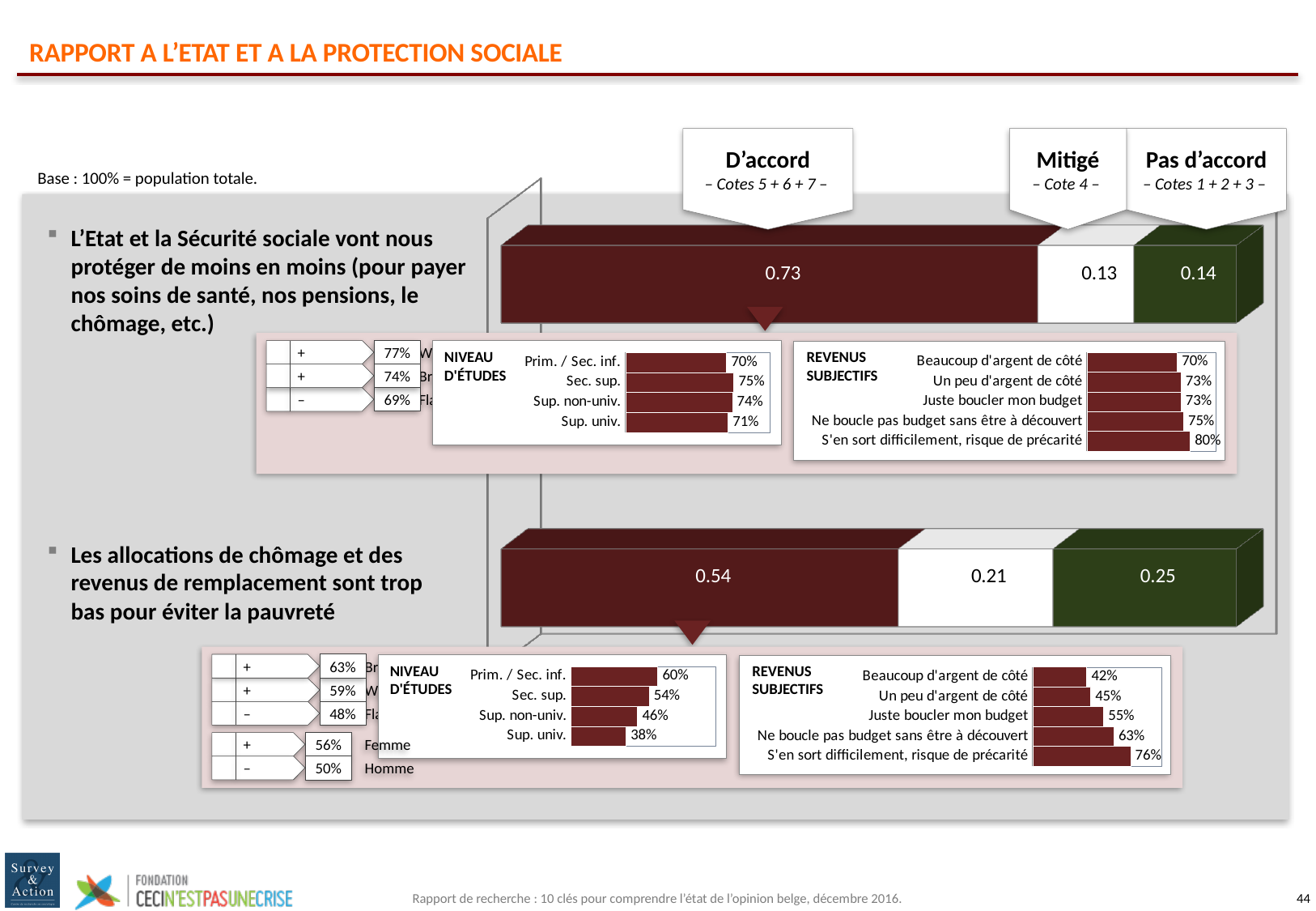
In the top 'NIVEAU D'ÉTUDES' bar chart (under the statement about 'L'Etat et la Sécurité sociale'), what is the value for 'Sup. non-univ.'? 74% In the bottom 'NIVEAU D'ÉTUDES' bar chart (under the statement about 'allocations de chômage'), do the values rise or fall from 'Prim. / Sec. inf.' to 'Sup. univ.'? fall In the top 'REVENUS SUBJECTIFS' bar chart (under the statement about 'L'Etat et la Sécurité sociale'), what is the value for 'S'en sort difficilement, risque de précarité'? 80% In the bottom 'REVENUS SUBJECTIFS' bar chart (under the statement about 'allocations de chômage'), what is the difference between 'S'en sort difficilement, risque de précarité' and 'Beaucoup d'argent de côté'? 34% In the bottom 'NIVEAU D'ÉTUDES' bar chart (under the statement about 'allocations de chômage'), which category has the lowest value? Sup. univ. In the top stacked bar for the statement 'L'Etat et la Sécurité sociale vont nous protéger de moins en moins', what is the value for 'D'accord'? 0.73 In the bottom stacked bar for the statement 'Les allocations de chômage et des revenus de remplacement sont trop bas pour éviter la pauvreté', what is the value for 'Pas d'accord'? 0.25 In the top 'NIVEAU D'ÉTUDES' bar chart (under the statement about 'L'Etat et la Sécurité sociale'), which category has the highest value? Sec. sup. In the bottom stacked bar for the statement about 'allocations de chômage', what is the value for 'Mitigé'? 0.21 In the top stacked bar for the statement about 'L'Etat et la Sécurité sociale', what is the difference between the 'D'accord' and 'Pas d'accord' values? 0.59 In the bottom 'REVENUS SUBJECTIFS' bar chart (under the statement about 'allocations de chômage'), how many categories are shown? 5 In the bottom 'REVENUS SUBJECTIFS' bar chart (under the statement about 'allocations de chômage'), which is larger: 'Un peu d'argent de côté' or 'Juste boucler mon budget'? Juste boucler mon budget